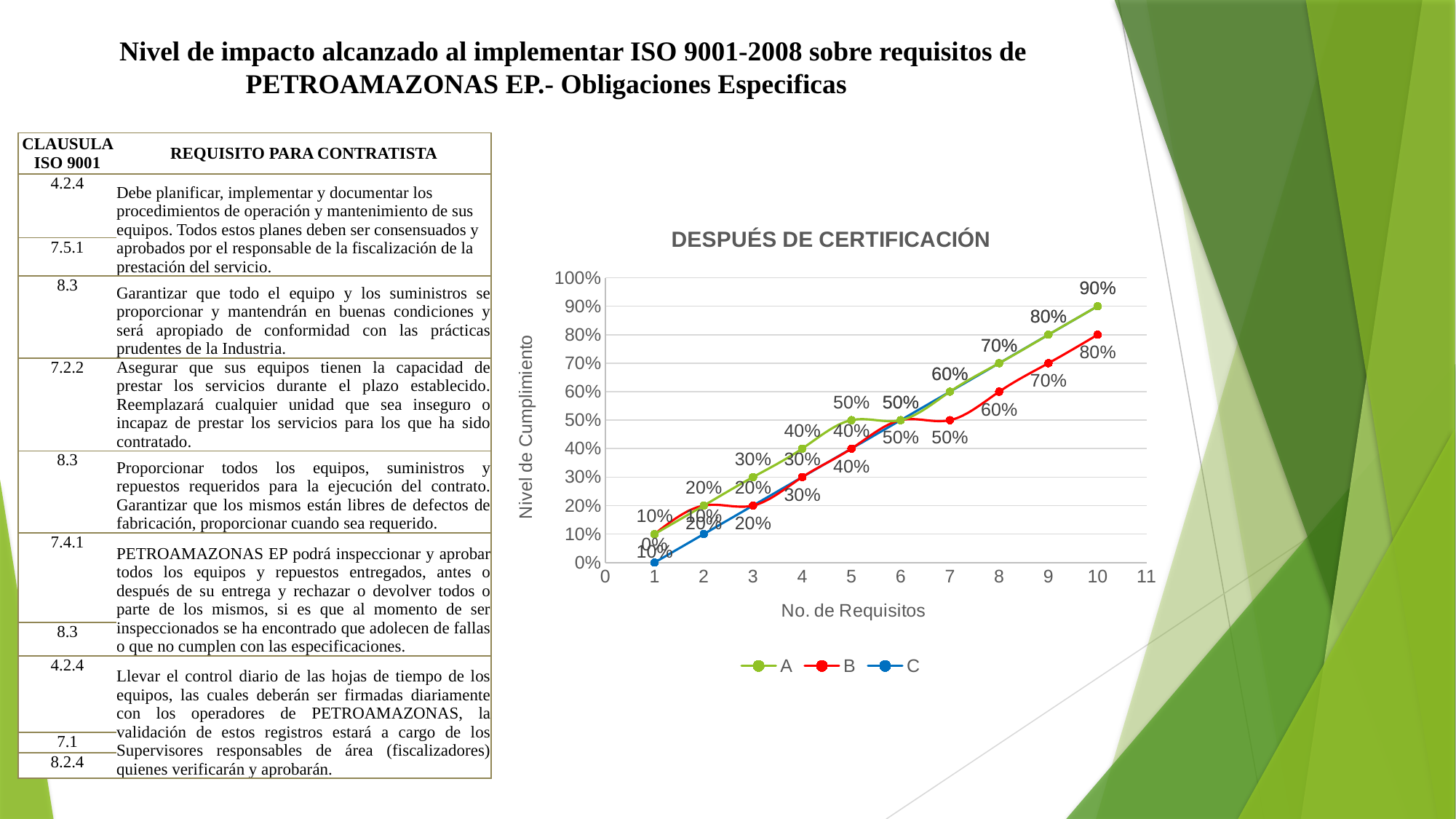
Do the values of series A rise or fall as the number of requisitos increases? rise What is the value of series B at requisito 10? 80% What is the value of series A at requisito 10? 90% At requisito 9, which series has the larger value, A or B? A What is the difference between series A and series B at requisito 10? 10% What is the value of series C at requisito 1? 0% At which requisito number does series A reach its highest value? 10 What is the title of the chart? DESPUÉS DE CERTIFICACIÓN What kind of chart is shown on the slide? line chart What is the value of series A at requisito 5? 50% How many series does the chart legend list? 3 How many data points are plotted for series A? 10